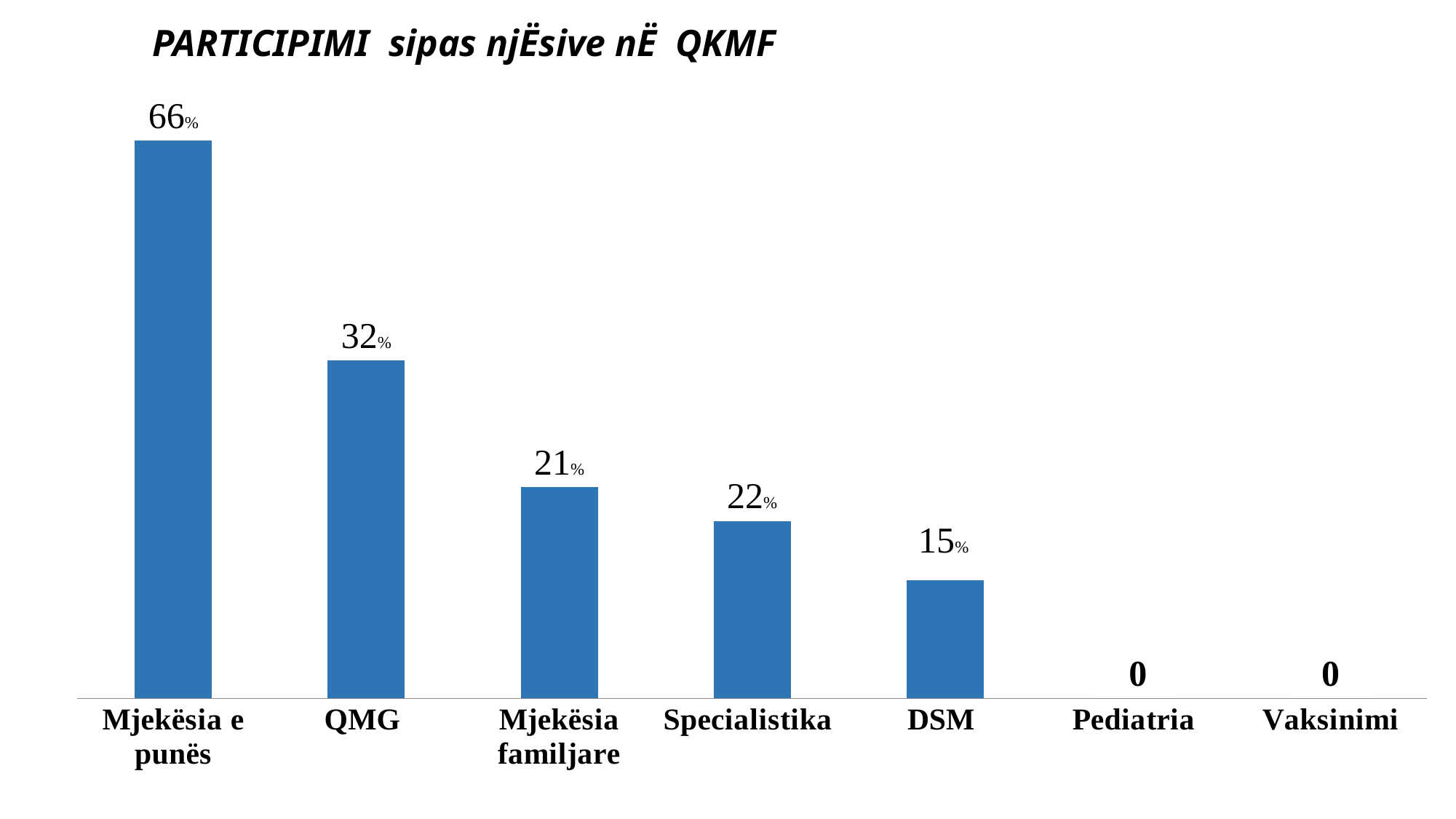
What is the title of the chart? PARTICIPIMI sipas njËsive nË QKMF What kind of chart is shown on the slide? Bar chart What is the value for Mjekësia familjare? 21% What is the value for Pediatria? 0 What is the value for Mjekësia e punës? 66% What is the difference between the values for Mjekësia e punës and QMG? 34% What is the value for DSM? 15% How many categories are shown on the x axis? 7 Which category has the highest value? Mjekësia e punës What is the difference between the values for Specialistika and DSM? 7% What is the value for QMG? 32%